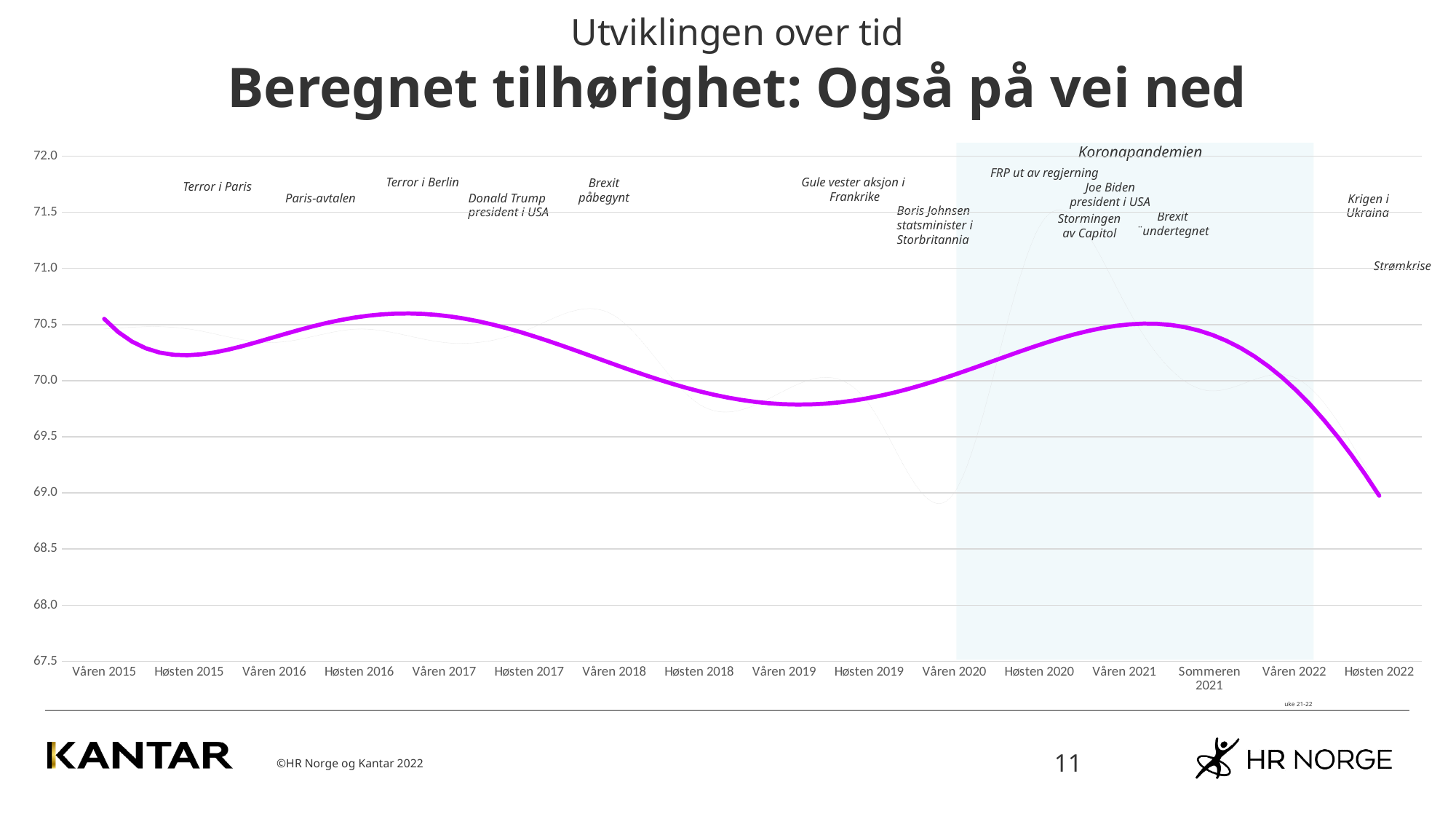
Is the value for Høsten 2016 greater or less than 70.0? greater Which is larger, the value for Våren 2015 or the value for Høsten 2022? Våren 2015 Is the value for Våren 2019 greater or less than 70.0? less What kind of chart is shown on the slide? Line chart What label is given to the shaded region on the right side of the chart? Koronapandemien Does the line rise or fall from Våren 2021 to Høsten 2022? Fall Which is larger, the value for Høsten 2016 or the value for Våren 2019? Høsten 2016 What is the main title of the chart on the slide? Beregnet tilhørighet: Også på vei ned Is the value for Våren 2015 greater or less than 70.0? greater Which period has the lowest value on the chart? Høsten 2022 How many time periods are labelled along the x axis of the chart? 16